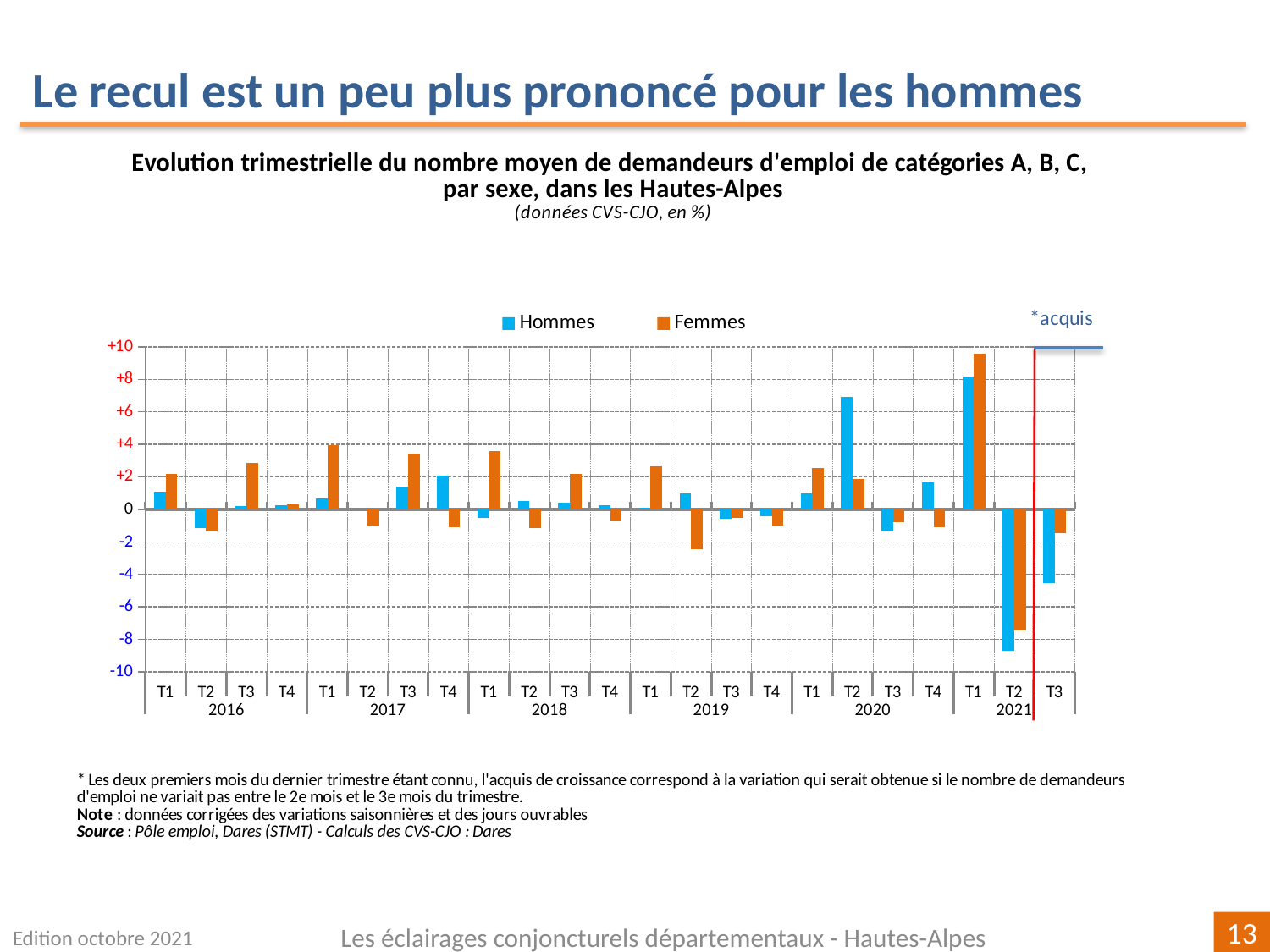
Is the value for Femmes in T1 2017 greater or less than +2? greater In which quarter does the Hommes series reach its lowest value? T2 2021 Is the value for Hommes in T2 2020 greater or less than +6? greater What are the two series named in the legend? Hommes and Femmes How many quarters are plotted along the x axis? 23 In T2 2020, which series has the higher value, Hommes or Femmes? Hommes In T3 2021, which series has the lower value, Hommes or Femmes? Hommes What kind of chart is shown on the slide? bar chart Is the value for Femmes in T2 2021 greater or less than -6? less In which quarter does the Femmes series reach its highest value? T1 2021 How many series does the legend list? 2 In which quarter does the Hommes series reach its highest value? T1 2021